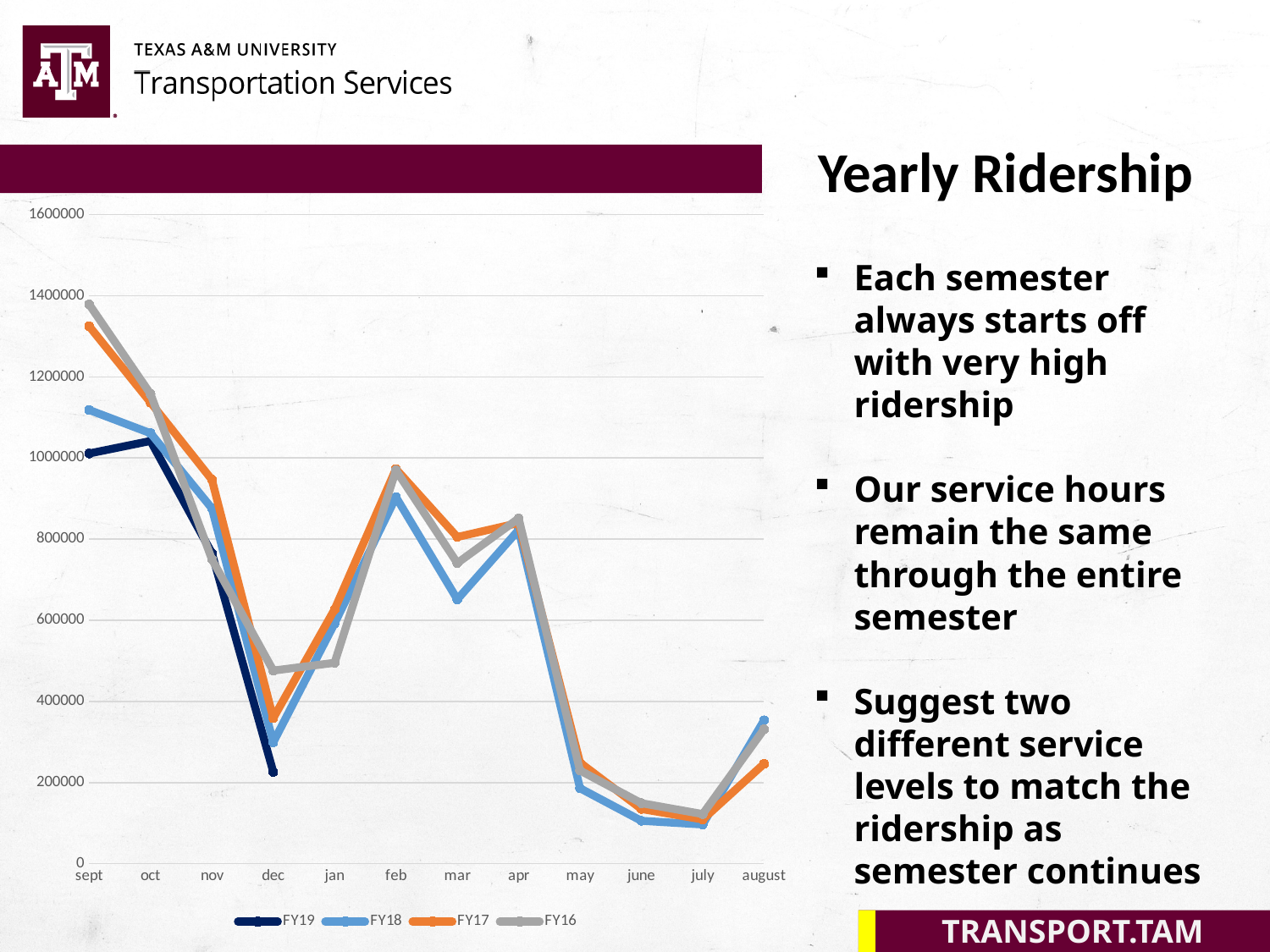
Which series has the lowest value in sept? FY19 How many series does the chart legend list? 4 In dec, which is larger: the FY16 value or the FY19 value? FY16 Is the FY17 value for july greater or less than 200000? less Is the FY19 value for dec greater or less than 400000? less In which month does the FY17 series reach its highest value? sept Is the FY16 value for sept greater or less than 1200000? greater Which series are listed in the chart legend? FY19, FY18, FY17, FY16 How many months are shown along the x axis of the chart? 12 In sept, which is larger: the FY16 value or the FY19 value? FY16 What kind of chart is shown on the slide? line chart